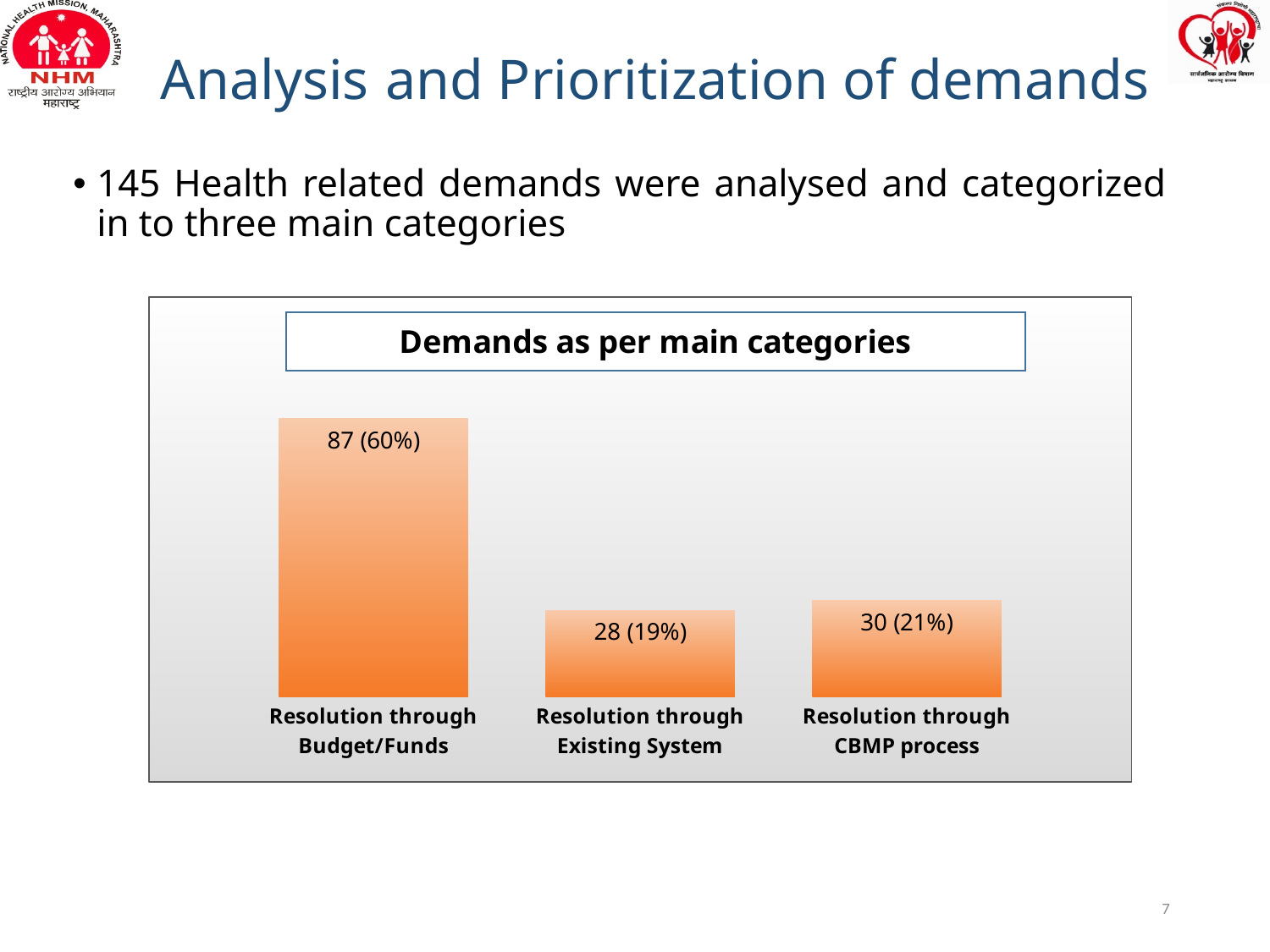
What type of chart is shown on the slide? Bar chart What is the value shown for Resolution through Budget/Funds? 87 (60%) Which category has the highest number of demands? Resolution through Budget/Funds What is the value shown for Resolution through Existing System? 28 (19%) Which category has the lowest number of demands? Resolution through Existing System What is the value shown for Resolution through CBMP process? 30 (21%) What is the total number of demands across the three categories in the chart? 145 What is the difference in demands between Resolution through Budget/Funds and Resolution through CBMP process? 57 What is the title of the chart? Demands as per main categories What is the difference in demands between Resolution through CBMP process and Resolution through Existing System? 2 Which has more demands, Resolution through Existing System or Resolution through Budget/Funds? Resolution through Budget/Funds How many categories are shown in the chart? 3